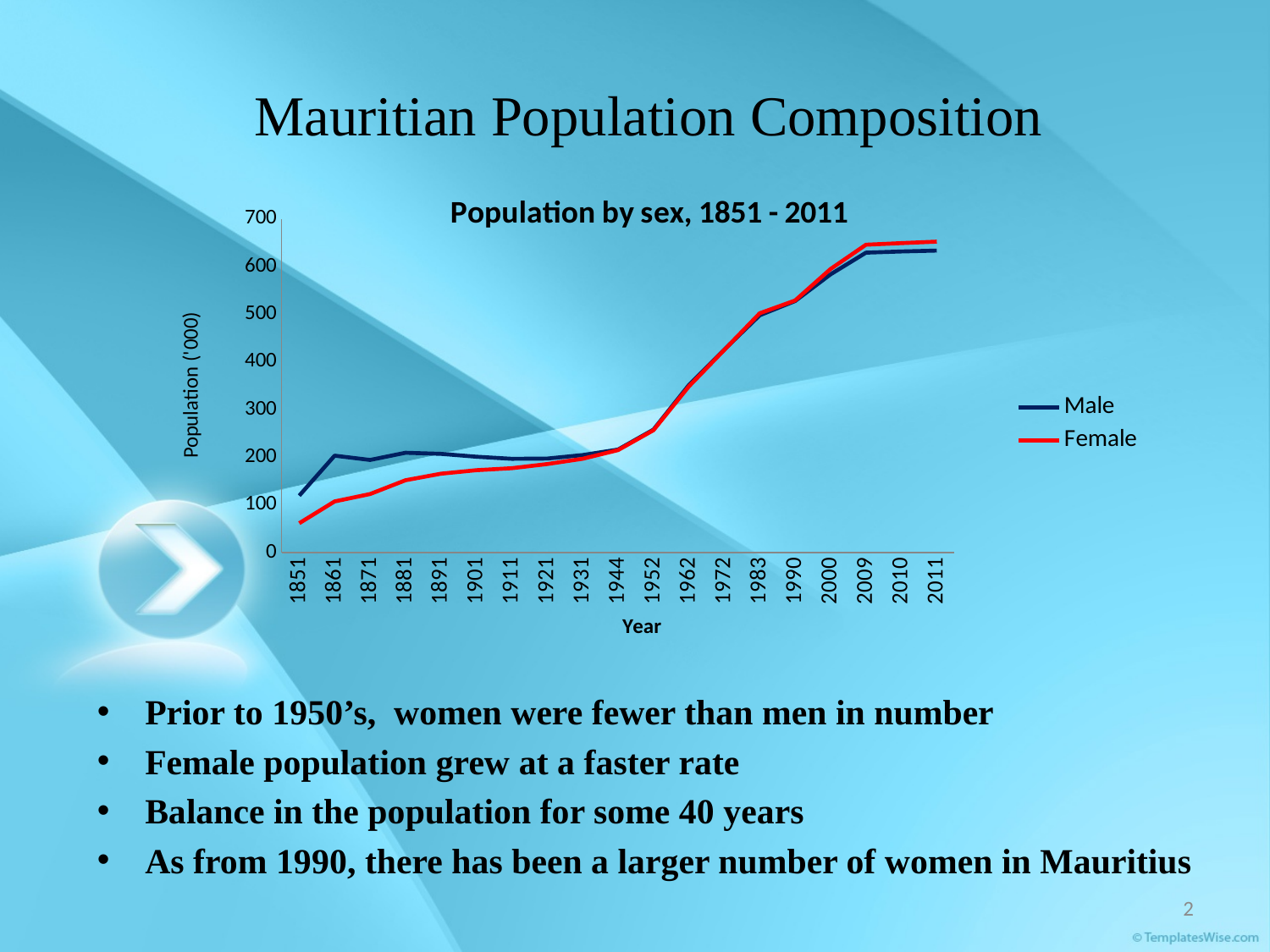
What is the title of the chart? Population by sex, 1851 - 2011 What kind of chart is shown on the slide? Line chart Is the Female value for 1851 greater or less than 100? less Which colour is used for the Female series? Red Is the Male value for 1962 greater or less than 300? greater How many years are plotted along the x axis? 19 In which year is the Female series at its lowest? 1851 How many series does the legend list? 2 In 2011, which series has the larger value, Male or Female? Female Is the Male value for 1851 greater or less than 100? greater In 1851, which series has the larger value, Male or Female? Male